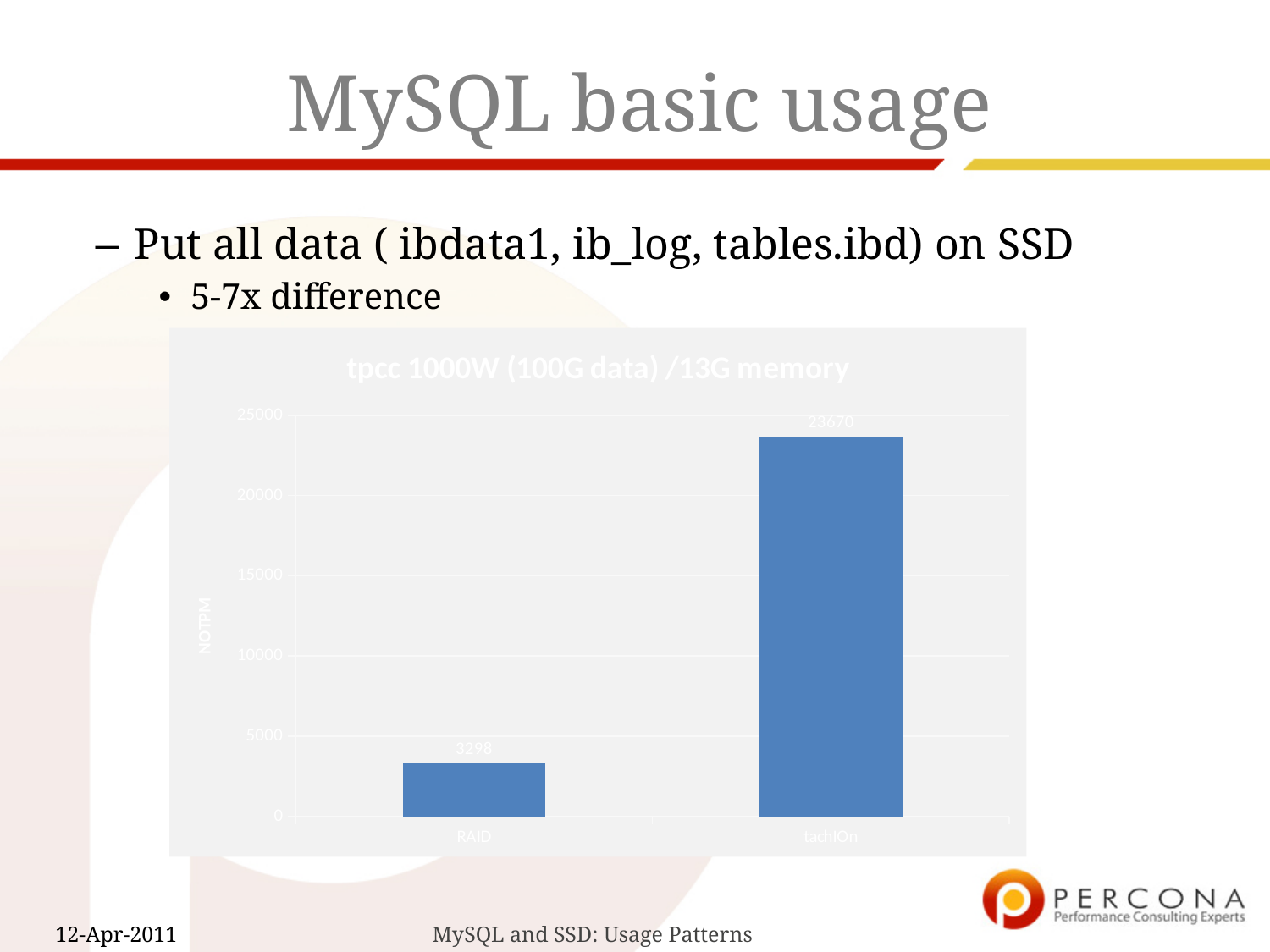
Is the value for tachIOn greater or less than 20000? greater What is the title of the chart? tpcc 1000W (100G data) /13G memory Which category has the highest NOTPM value? tachIOn What is the NOTPM value for tachIOn? 23670 Which category has the lowest NOTPM value? RAID What is the difference in NOTPM between tachIOn and RAID? 20372 What kind of chart is shown on the slide? bar chart Is the value for RAID greater or less than 5000? less What is the label of the y axis of the chart? NOTPM Which has a larger NOTPM value, RAID or tachIOn? tachIOn What is the NOTPM value for RAID? 3298 How many categories are shown on the x axis of the chart? 2